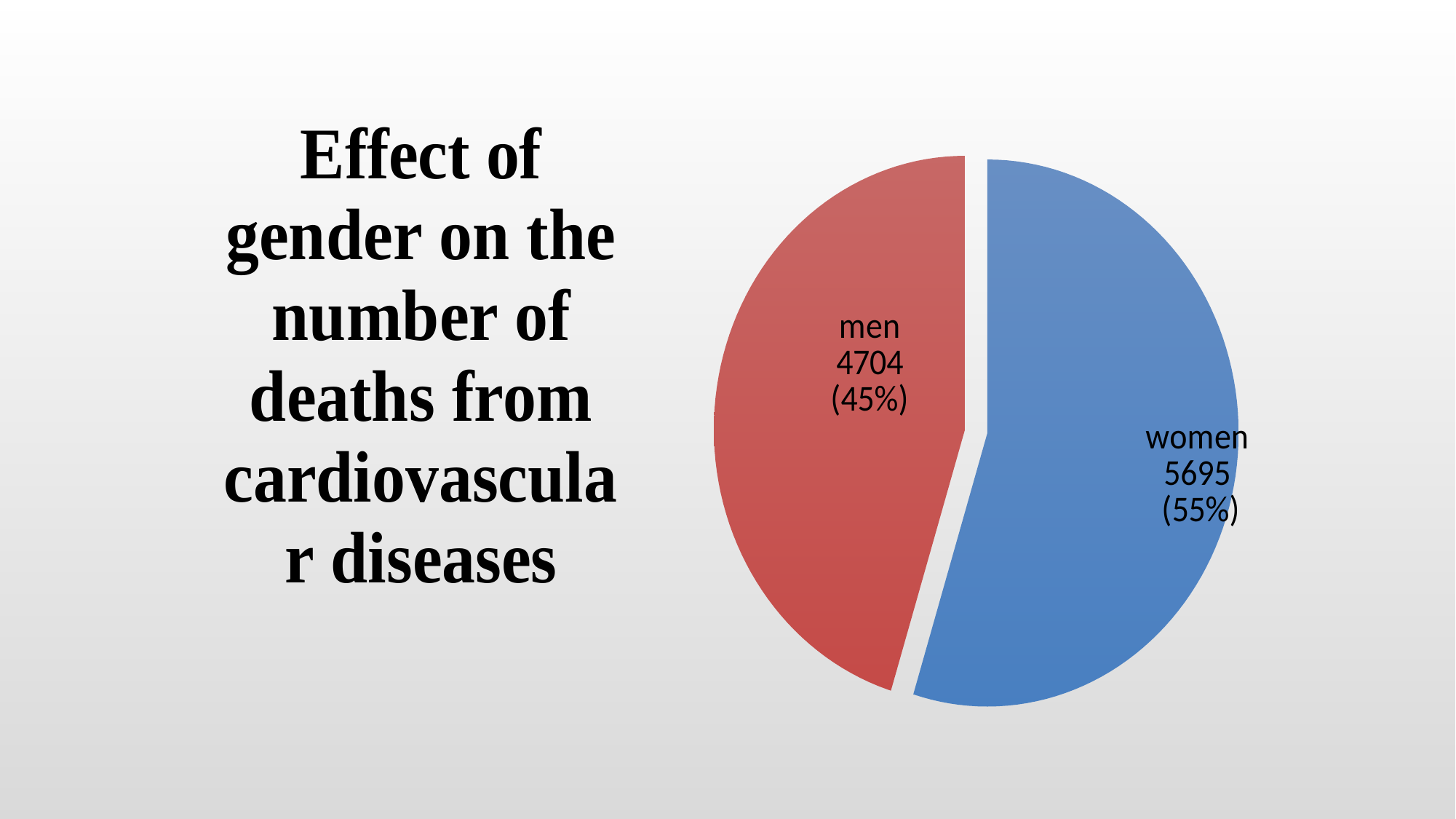
What colour is the slice for women? blue Which category has the smaller number of deaths? men What is the difference between the number of deaths for women and for men? 991 What kind of chart is shown on the slide? pie chart Is the value for men larger or smaller than the value for women? smaller What is the number of deaths for women? 5695 What share of the pie does the women slice represent? 55% What is the number of deaths for men? 4704 Which category has the larger number of deaths? women What share of the pie does the men slice represent? 45% How many slices does the pie chart have? 2 What is the total number of deaths across both slices? 10399